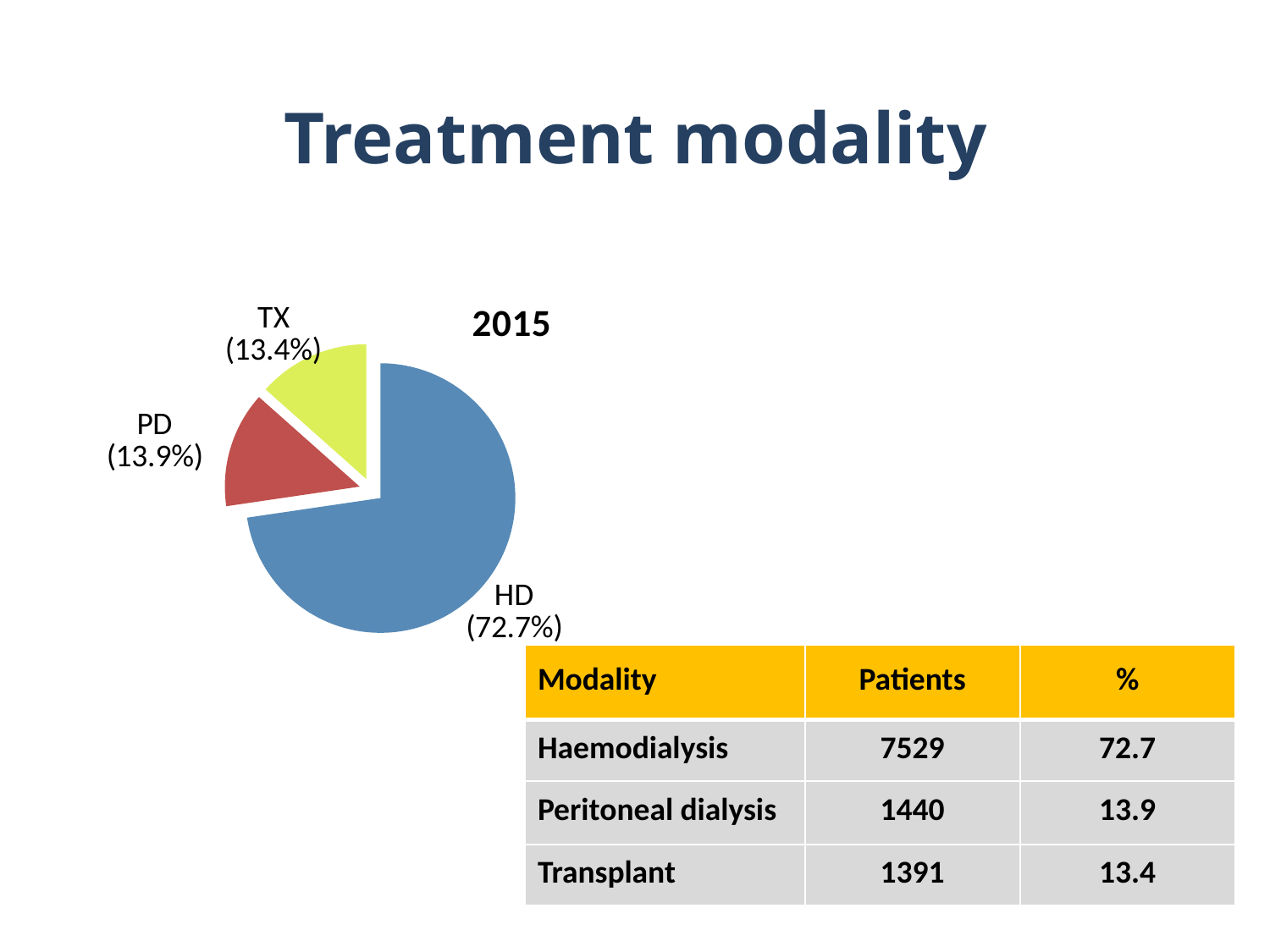
What is the difference in percentage points between the PD and TX slices? 0.5 Which is larger, the PD slice or the TX slice? PD What is the difference in percentage points between the HD and PD slices? 58.8 What colour is the HD slice of the pie chart? blue How many slices does the pie chart have? 3 What year is shown as the label of the pie chart? 2015 Which slice of the pie is the largest? HD What share of the pie does TX represent? 13.4% What kind of chart is shown on the slide? pie chart What share of the pie does PD represent? 13.9% What share of the pie does HD represent? 72.7% Which slice of the pie is the smallest? TX